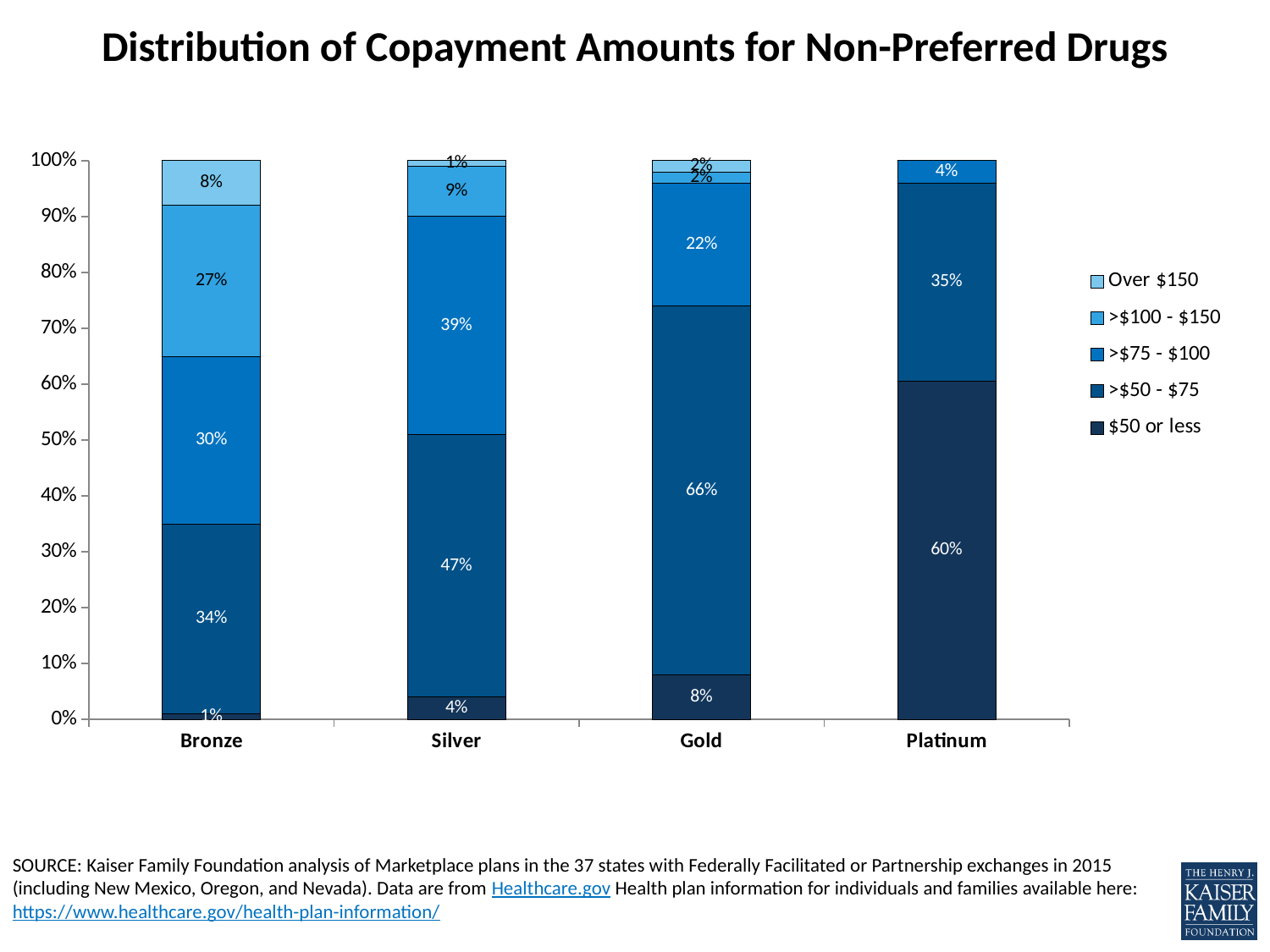
What percentage of Platinum plans have a copayment of $50 or less for non-preferred drugs? 60% What is the value of the >$50 - $75 segment for Silver? 47% Which plan tier has the highest share of copayments of $50 or less? Platinum How many plan tiers are shown on the x axis? 4 Which plan tier has the lowest share of copayments of $50 or less? Bronze Which is larger: the >$75 - $100 share for Silver or for Platinum? Silver How many series does the legend list? 5 What is the value of the >$75 - $100 segment for Gold? 22% What kind of chart is shown on the slide? Stacked bar chart What is the title of the chart? Distribution of Copayment Amounts for Non-Preferred Drugs What is the value of the >$100 - $150 segment for Bronze? 27% What is the difference between the >$50 - $75 share for Gold and for Bronze? 32%